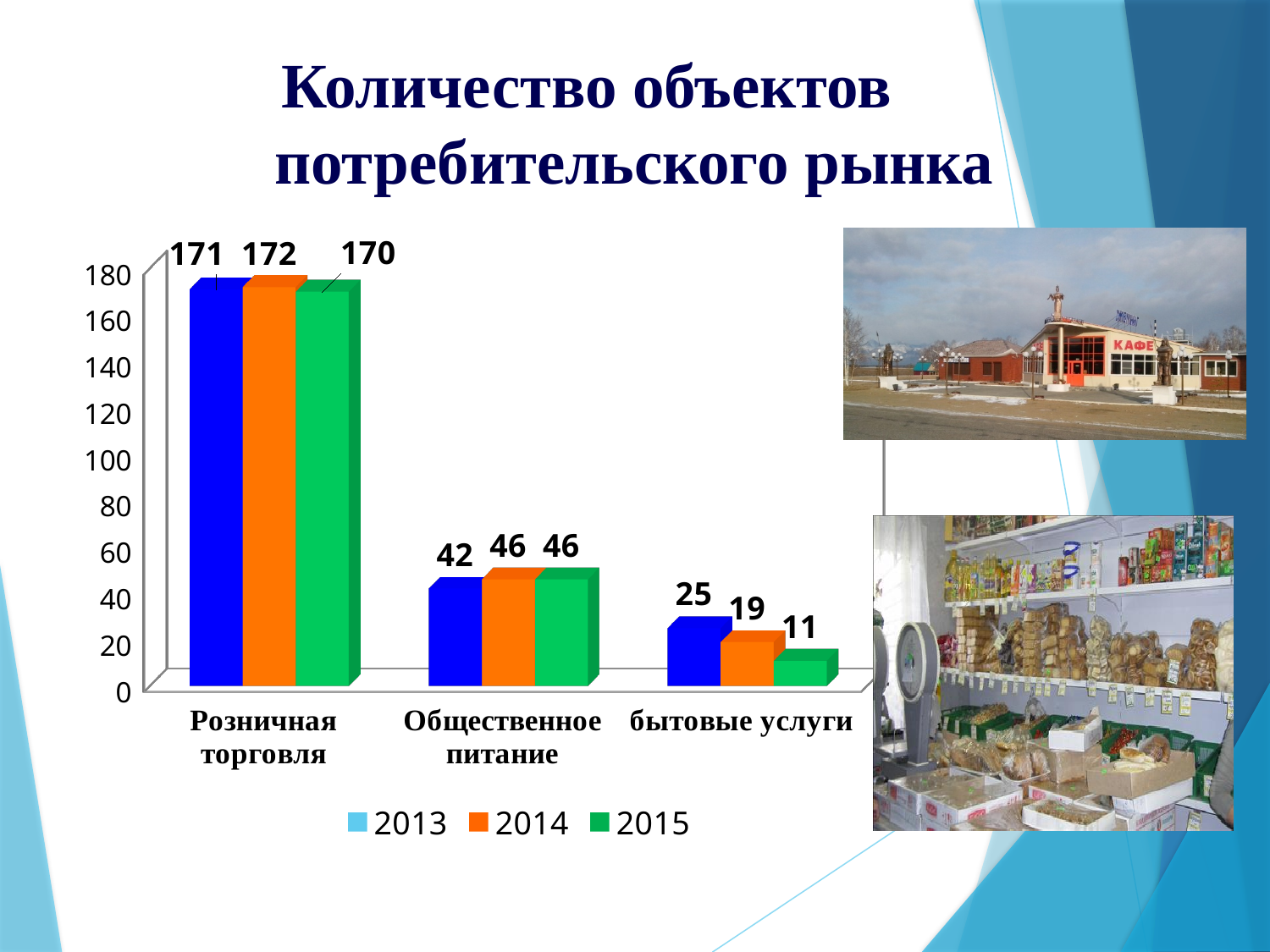
What is the value for Общественное питание in 2013? 42 Which is larger for Общественное питание: the 2013 value or the 2014 value? 2014 What is the value for Розничная торговля in 2014? 172 Do the values for бытовые услуги rise or fall from 2013 to 2015? fall Which category has the lowest value in 2015? бытовые услуги Which category has the highest value in 2013? Розничная торговля What is the value for бытовые услуги in 2015? 11 What is the difference between the 2013 and 2015 values for бытовые услуги? 14 Is the value for Розничная торговля in 2015 greater or less than 160? greater How many series does the legend list? 3 How many categories are shown on the x axis? 3 What kind of chart is shown on the slide? bar chart